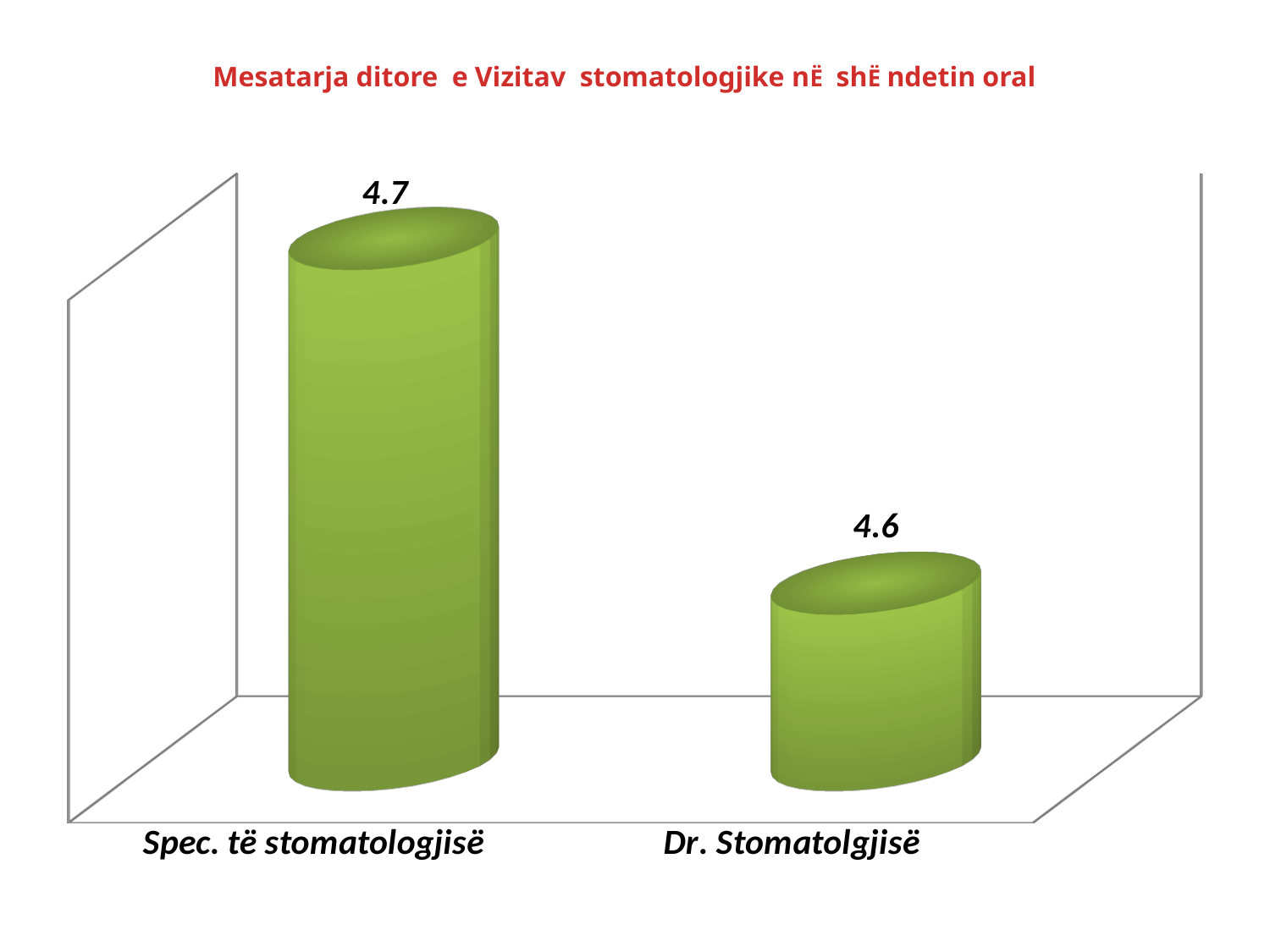
Do the values rise or fall from left to right across the categories? Fall Which category has the highest value? Spec. të stomatologjisë What colour are the bars in the chart? Green What is the value for Spec. të stomatologjisë? 4.7 Which is larger, the value for Spec. të stomatologjisë or the value for Dr. Stomatolgjisë? Spec. të stomatologjisë What is the title of the chart? Mesatarja ditore e Vizitav stomatologjike në shëndetin oral What kind of chart is shown on the slide? Bar chart What is the value for Dr. Stomatolgjisë? 4.6 What is the difference between the values for Spec. të stomatologjisë and Dr. Stomatolgjisë? 0.1 Which category has the lowest value? Dr. Stomatolgjisë How many categories are shown in the chart? 2